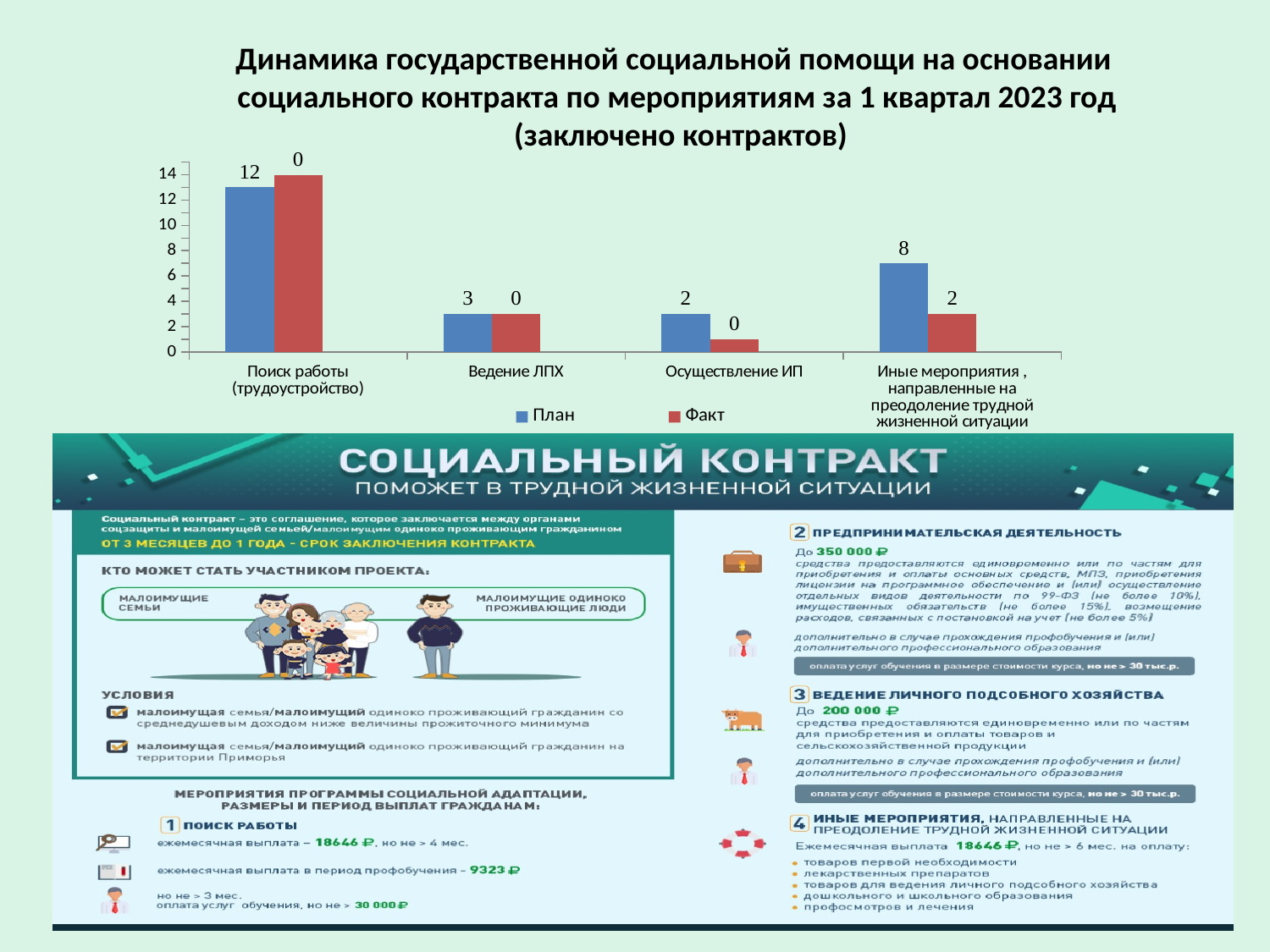
What is the Факт data label for Иные мероприятия, направленные на преодоление трудной жизненной ситуации? 2 How many series does the chart legend list? 2 What kind of chart is shown on the slide? Bar chart What is the План value for Осуществление ИП? 2 What is the План value for Ведение ЛПХ? 3 How many categories are shown on the x axis of the chart? 4 What is the План value for Поиск работы (трудоустройство)? 12 What is the План value for Иные мероприятия, направленные на преодоление трудной жизненной ситуации? 8 Which category has the highest План value? Поиск работы (трудоустройство) What is the difference between the План values for Поиск работы (трудоустройство) and Иные мероприятия? 4